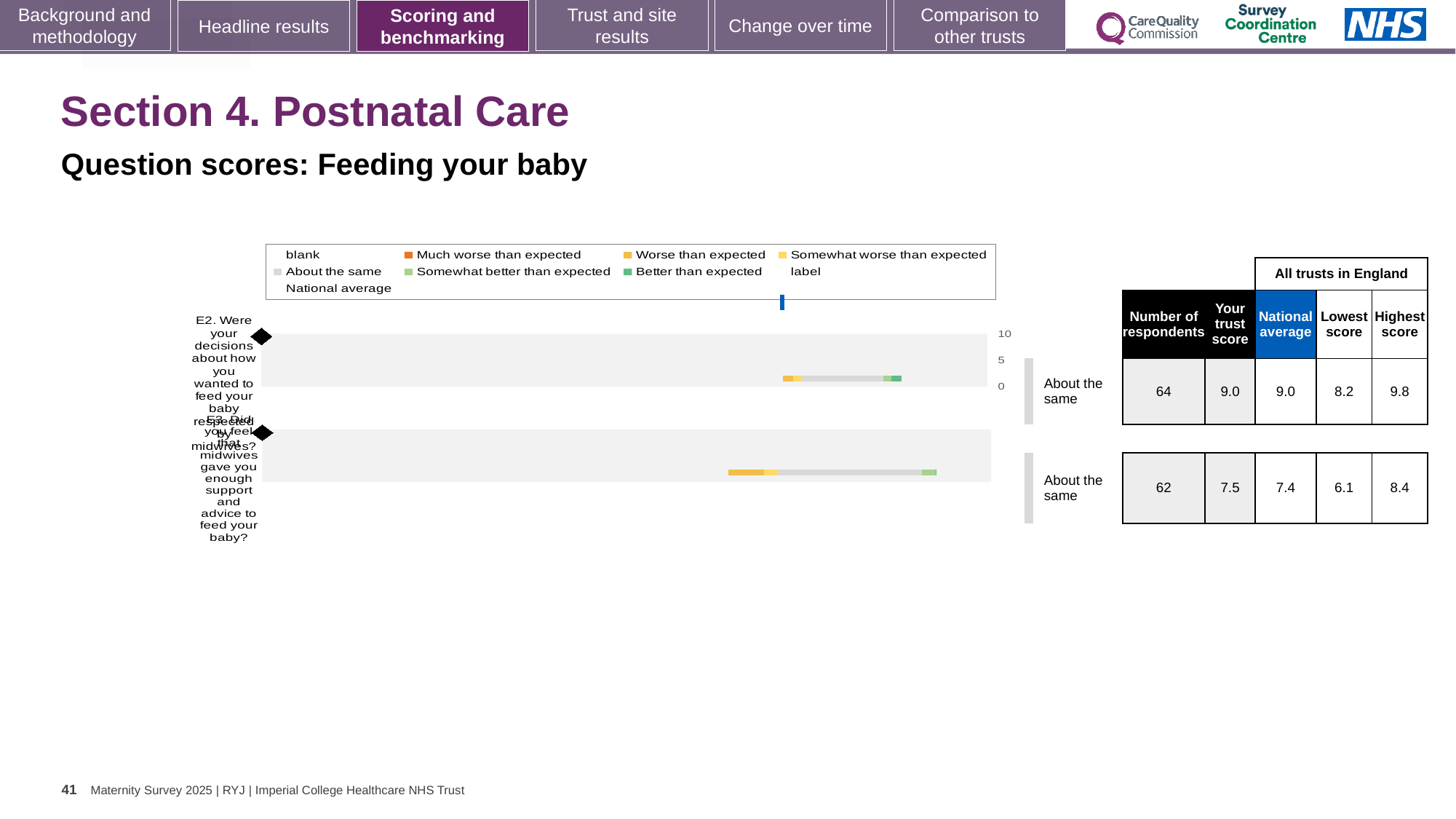
What benchmark category is shown next to the bar for question E3? About the same How many survey questions are plotted in the chart? 2 According to the table beside the chart, what is the highest score for question E3? 8.4 What is the difference between the highest score and the lowest score for question E2? 1.6 According to the table beside the chart, how many respondents answered question E2? 64 By how much does the trust score for question E3 exceed the national average? 0.1 According to the table beside the chart, what is the national average for question E2? 9.0 What colour does the legend use for 'Much worse than expected'? orange According to the table beside the chart, what is the lowest score for question E2? 8.2 What kind of chart is shown on the slide? bar chart According to the table beside the chart, what is the trust score for question E3? 7.5 Which question has the higher trust score, E2 or E3? E2